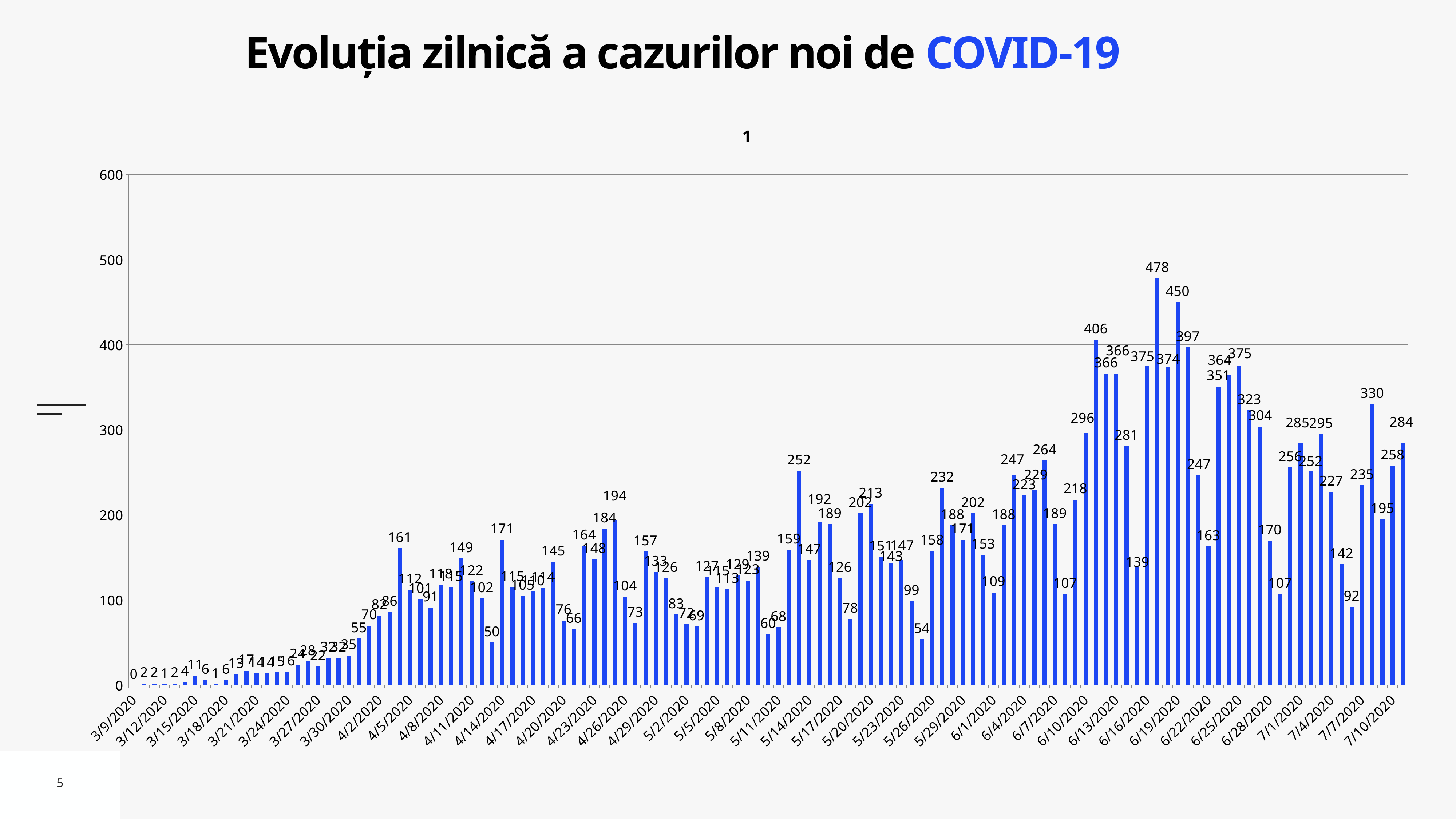
What is the lowest daily value shown in the chart? 0 What kind of chart is shown on the slide? bar chart What is the highest daily value shown in the chart? 478 What is the maximum value shown on the vertical axis? 600 Is the value for 7/10/2020 greater or less than 300? less Which is larger, the bar labelled 478 or the bar labelled 450? 478 What is the difference between the highest value (478) and the second highest value (450)? 28 Is the highest bar in the chart greater or less than 400? greater Overall, do the daily values rise or fall from March to July 2020? rise What is the value for the first date, 3/9/2020? 0 What is the value for the last date, 7/10/2020? 258 What is the title of the slide? Evoluția zilnică a cazurilor noi de COVID-19